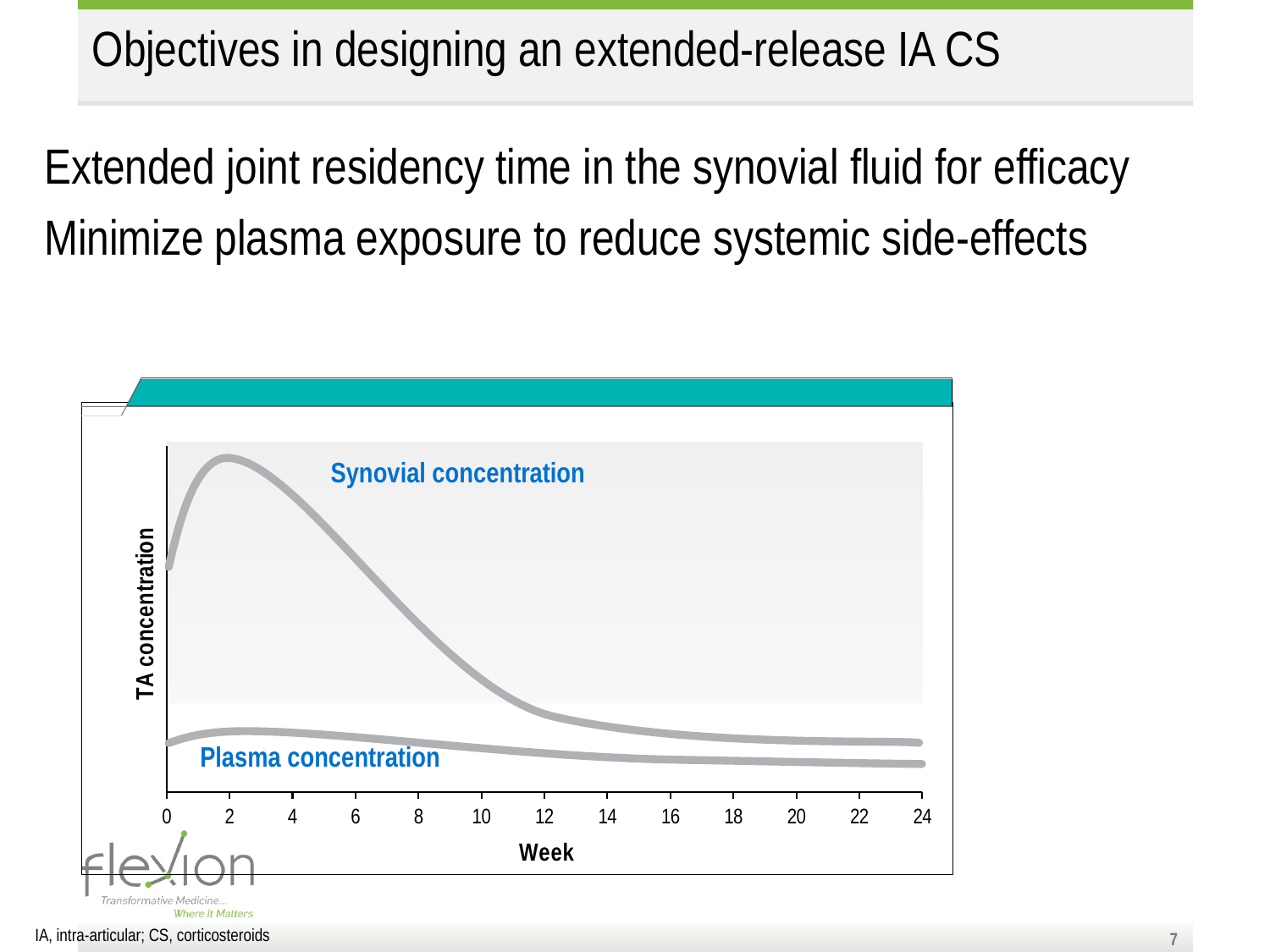
What kind of chart is shown on the slide? Line chart What is the highest week value shown on the x axis? 24 What is the label of the y axis of the chart? TA concentration Does the Synovial concentration curve rise or fall between week 0 and week 2? Rise What are the two curves on the chart labelled? Synovial concentration and Plasma concentration What is the label of the x axis of the chart? Week How many curves are plotted on the chart? 2 At week 12, which curve is higher, Synovial concentration or Plasma concentration? Synovial concentration How many tick labels are shown on the x axis? 13 At week 4, which curve is higher, Synovial concentration or Plasma concentration? Synovial concentration Does the Plasma concentration curve rise or fall between week 6 and week 24? Fall Does the Synovial concentration curve rise or fall between week 4 and week 24? Fall